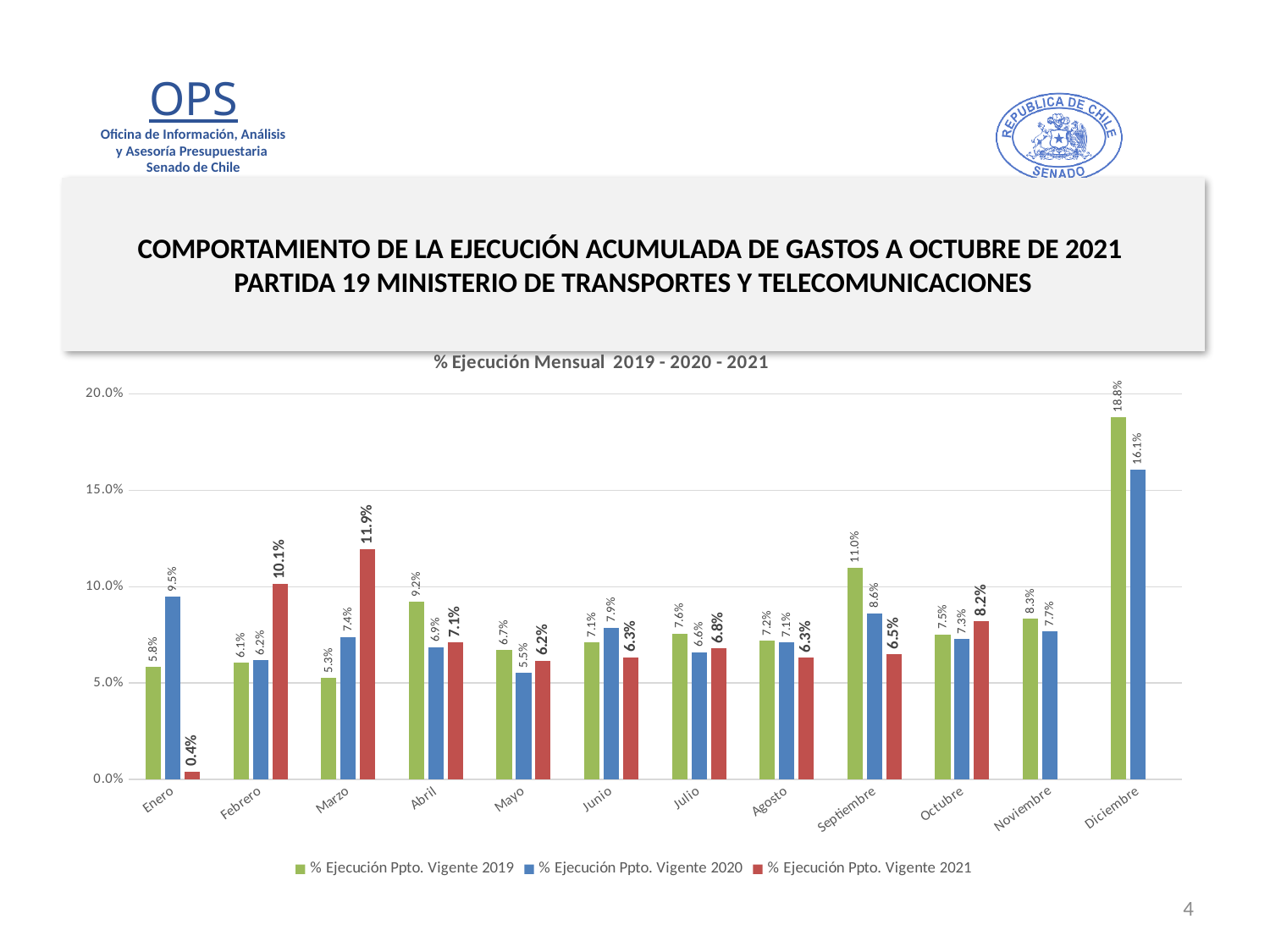
What is the title of the chart? % Ejecución Mensual 2019 - 2020 - 2021 What is the value for % Ejecución Ppto. Vigente 2019 in Diciembre? 18.8% What is the difference between the 2021 and 2019 values in Febrero? 4.0% Which month has the lowest value for % Ejecución Ppto. Vigente 2021? Enero Is the value for % Ejecución Ppto. Vigente 2019 in Diciembre greater or less than 15.0%? greater How many months are shown on the x axis? 12 What is the value for % Ejecución Ppto. Vigente 2021 in Marzo? 11.9% What kind of chart is shown? Bar chart What is the value for % Ejecución Ppto. Vigente 2020 in Enero? 9.5% Which month has the highest value for % Ejecución Ppto. Vigente 2020? Diciembre How many series does the legend list? 3 Which is larger in Septiembre: the 2019 value or the 2020 value? 2019 (11.0%)